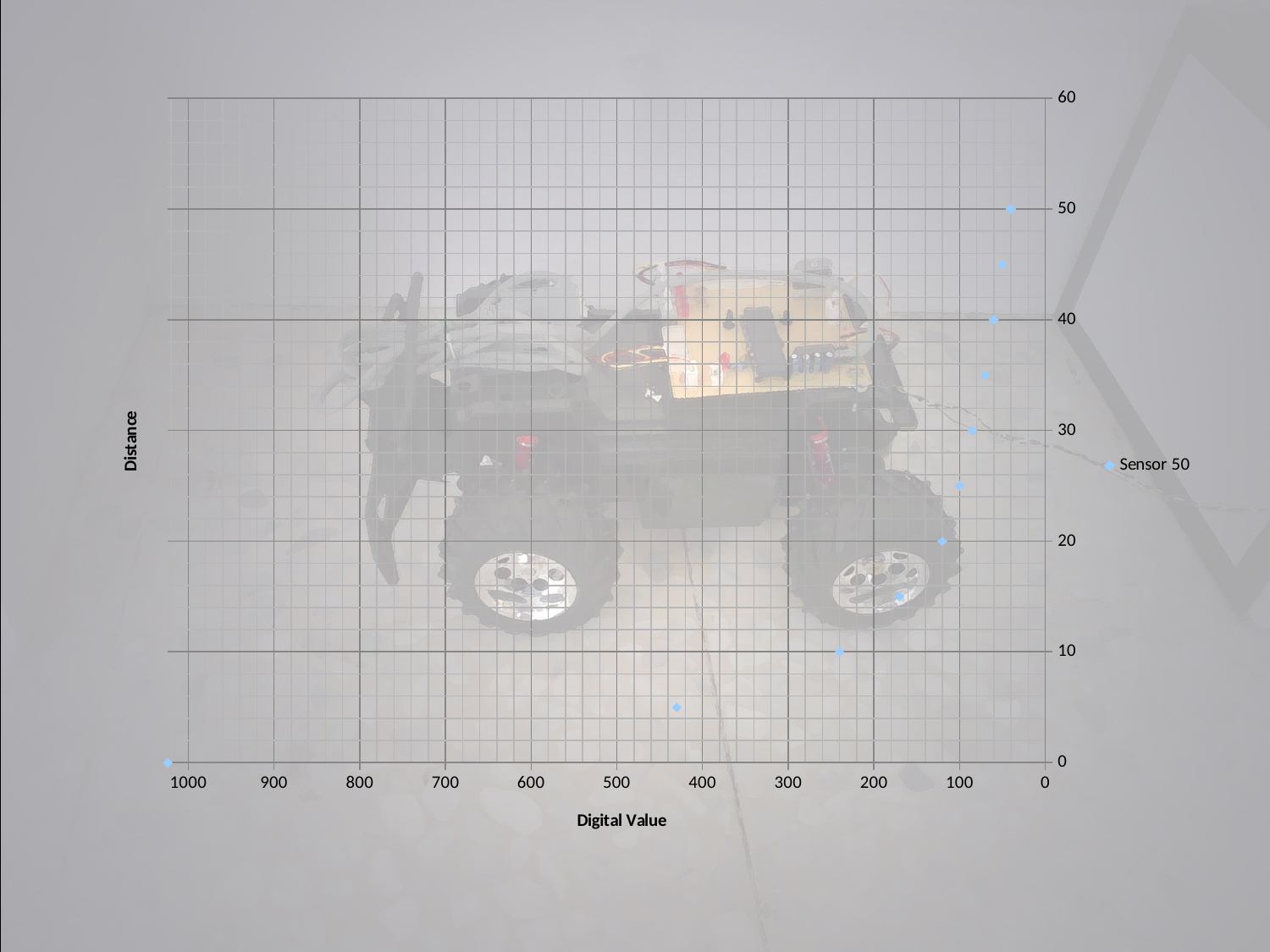
Is the Distance of the highest plotted point greater or less than 60? less How many series does the legend list? 1 How many data points are plotted for the Sensor 50 series? 11 Is the Distance of the highest plotted point greater or less than 40? greater What kind of chart is shown on the slide? scatter chart What is the title of the y axis? Distance What is the title of the x axis? Digital Value Is the Digital Value of the leftmost plotted point greater or less than 900? greater Moving from left to right along the x axis, does the Distance of the plotted points rise or fall? rise Which plotted point has the lowest Distance: the one at the far left of the chart or the one at the far right? the one at the far left